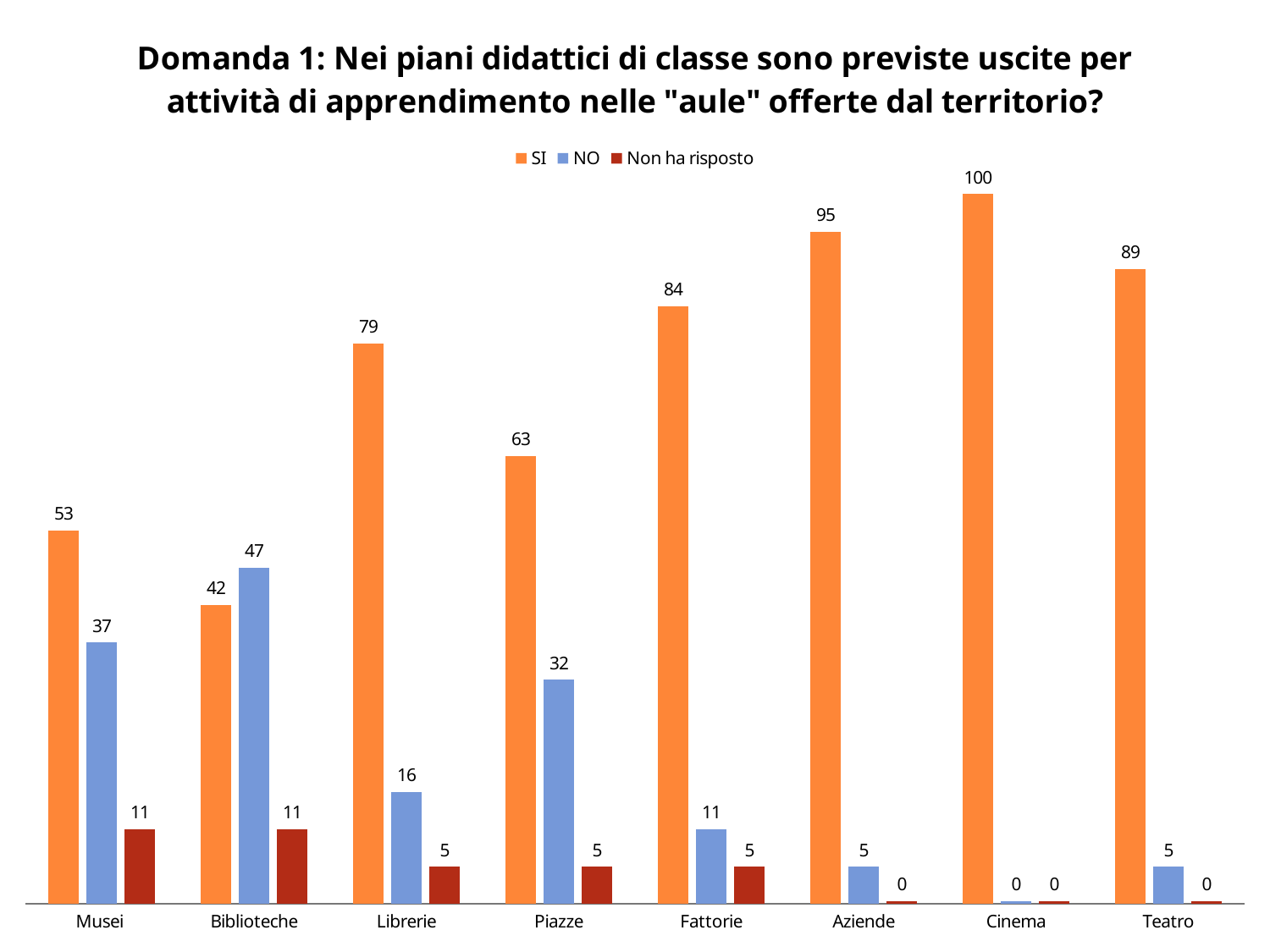
What kind of chart is shown on the slide? Bar chart What is the NO value for Piazze? 32 Which is larger for Biblioteche, the SI value or the NO value? NO Which series is shown in orange? SI What is the Non ha risposto value for Musei? 11 What is the difference between the SI value for Aziende and the SI value for Fattorie? 11 Which category has the highest SI value? Cinema Which category has the lowest SI value? Biblioteche How many series does the legend list? 3 What is the SI value for Librerie? 79 How many categories are shown on the x axis? 8 What is the NO value for Biblioteche? 47